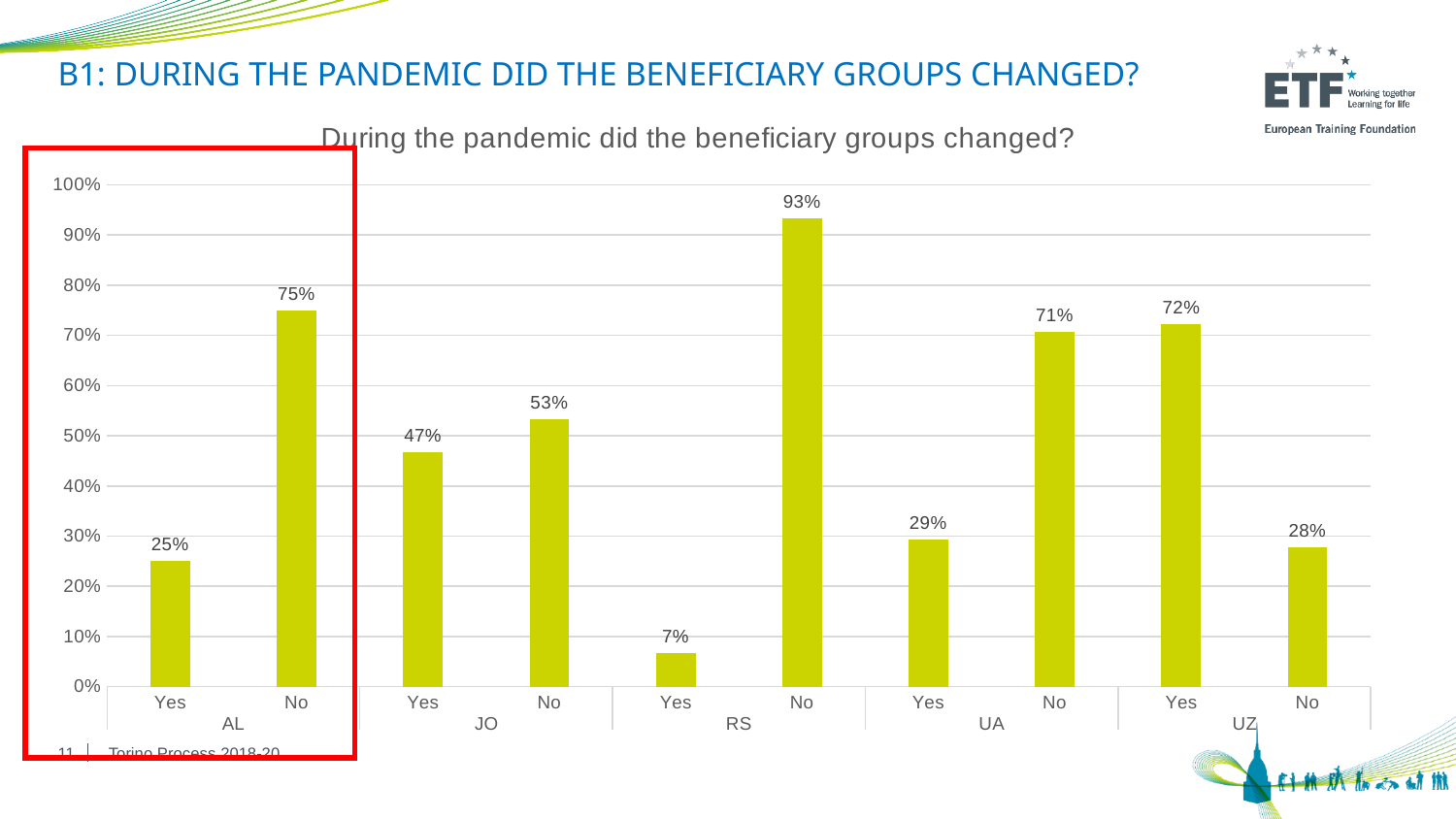
What is the value for "Yes" in the RS group? 7% What is the value for "Yes" in the UZ group? 72% What is the difference between the "No" and "Yes" values in the JO group? 6 percentage points What type of chart is shown on the slide? Bar chart What is the value for "No" in the UA group? 71% Which bar has the highest value on the chart? No in RS (93%) What is the title of the chart? During the pandemic did the beneficiary groups changed? What is the value for "No" in the AL group? 75% Is the value for "No" in the RS group greater or less than 90%? greater How many bars are plotted on the chart? 10 Which bar has the lowest value on the chart? Yes in RS (7%) Which is larger: the "Yes" value for UZ or the "Yes" value for UA? Yes for UZ (72%)